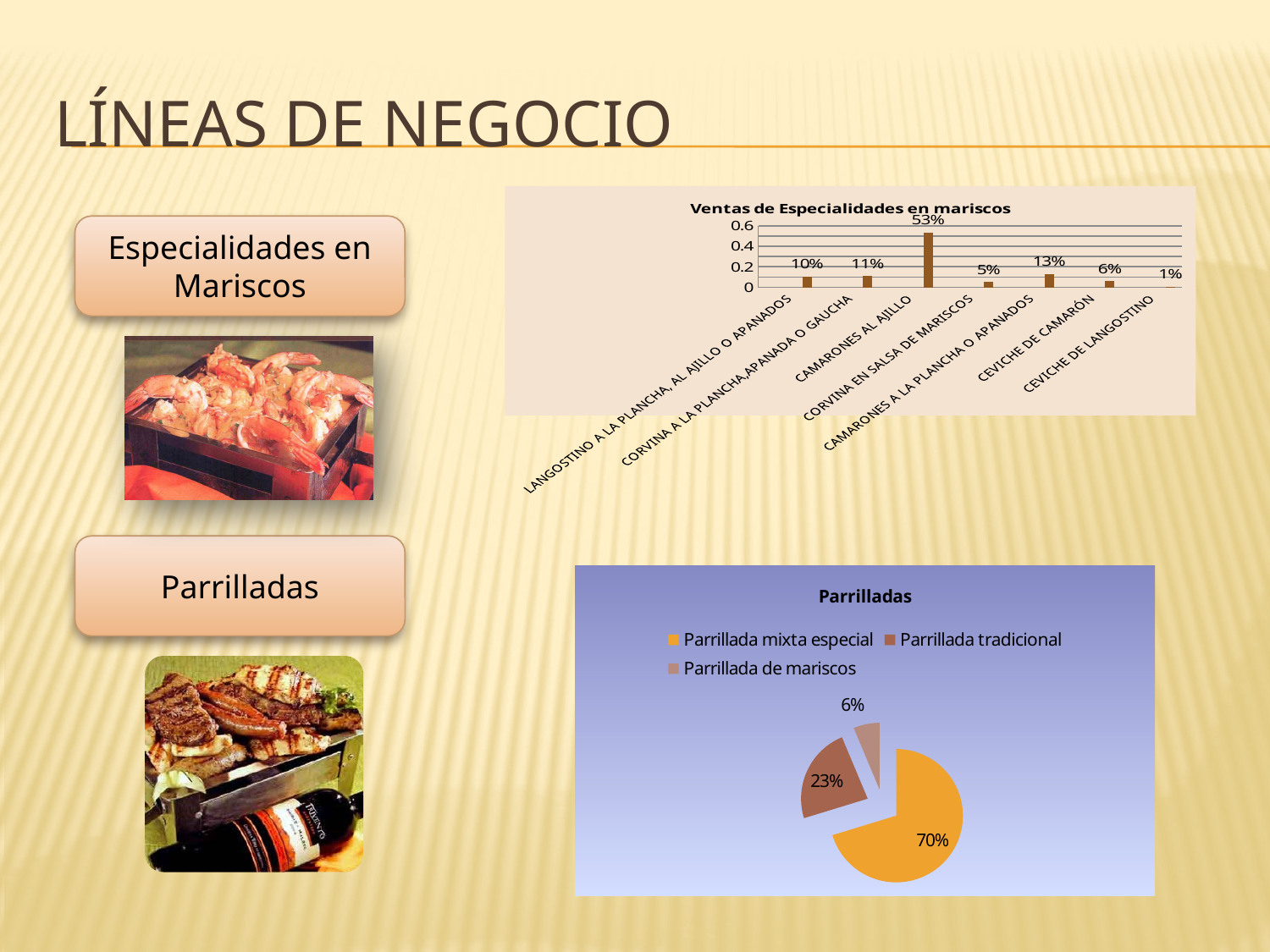
In the 'Ventas de Especialidades en mariscos' chart, which category has the lowest value? CEVICHE DE LANGOSTINO In the 'Ventas de Especialidades en mariscos' chart, what is the difference between CAMARONES A LA PLANCHA O APANADOS and CORVINA EN SALSA DE MARISCOS? 8% In the 'Parrilladas' chart, which category has the smallest slice? Parrillada de mariscos In the 'Ventas de Especialidades en mariscos' chart, which category has the highest value? CAMARONES AL AJILLO How many entries does the legend of the 'Parrilladas' chart list? 3 In the 'Ventas de Especialidades en mariscos' chart, which is larger: CORVINA A LA PLANCHA APANADA O GAUCHA or CEVICHE DE CAMARÓN? CORVINA A LA PLANCHA APANADA O GAUCHA What kind of chart is 'Ventas de Especialidades en mariscos'? Bar chart In the 'Ventas de Especialidades en mariscos' chart, what is the value for CAMARONES AL AJILLO? 53% In the 'Ventas de Especialidades en mariscos' chart, what is the value for CEVICHE DE CAMARÓN? 6% In the 'Parrilladas' chart, what is the value for Parrillada tradicional? 23% In the 'Parrilladas' chart, what share does Parrillada mixta especial have? 70% How many categories are shown in the 'Ventas de Especialidades en mariscos' chart? 7